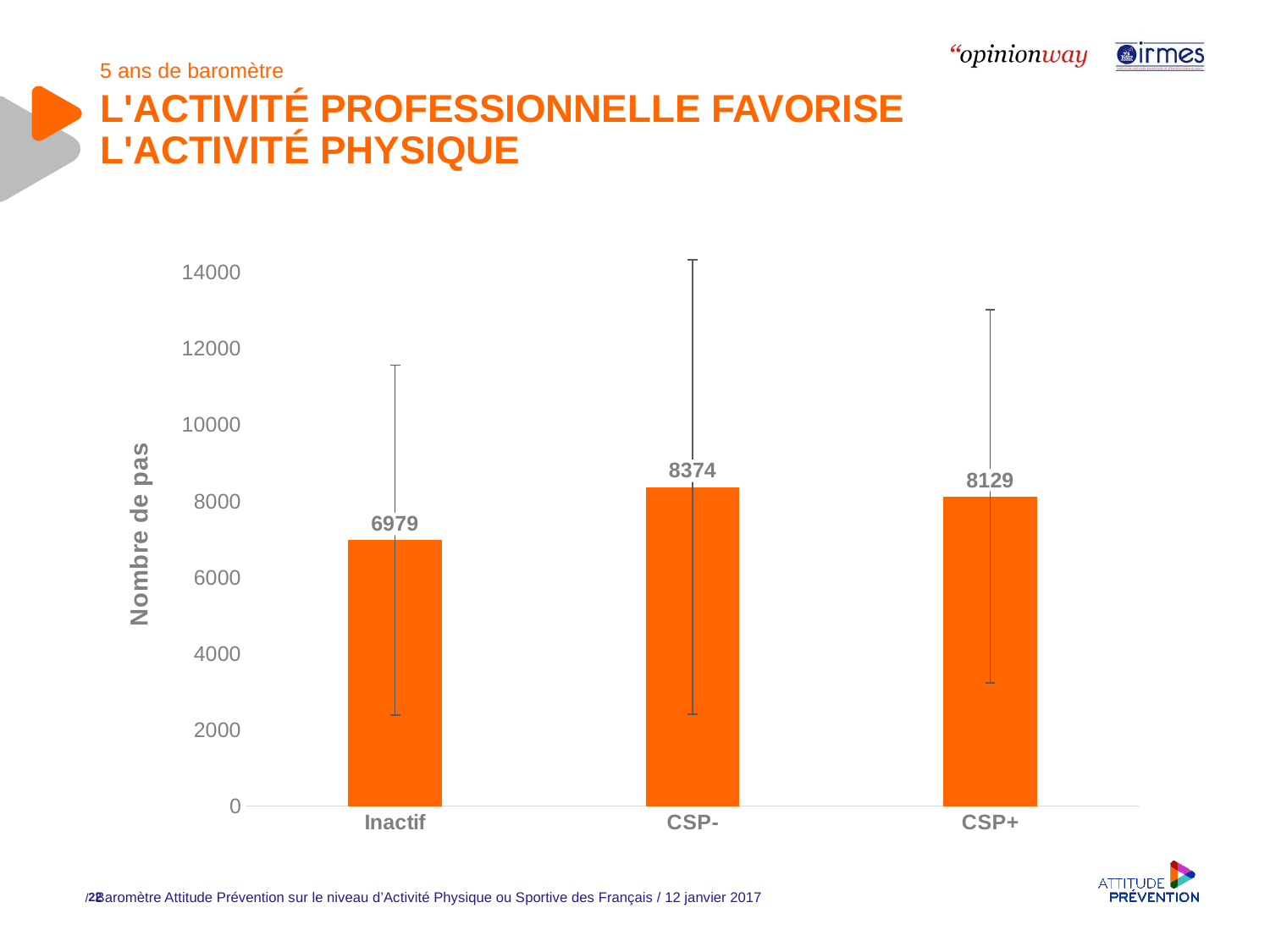
Is the value for Inactif greater or less than 8000? less What is the label of the vertical axis? Nombre de pas What is the difference in number of steps between CSP- and Inactif? 1395 What is the number of steps for CSP+? 8129 How many categories are shown on the x axis? 3 What is the difference in number of steps between CSP- and CSP+? 245 What kind of chart is shown on the slide? bar chart Which category has the lowest number of steps? Inactif Which category has the highest number of steps? CSP- Which has more steps, Inactif or CSP+? CSP+ What is the number of steps (Nombre de pas) for Inactif? 6979 What is the number of steps for CSP-? 8374